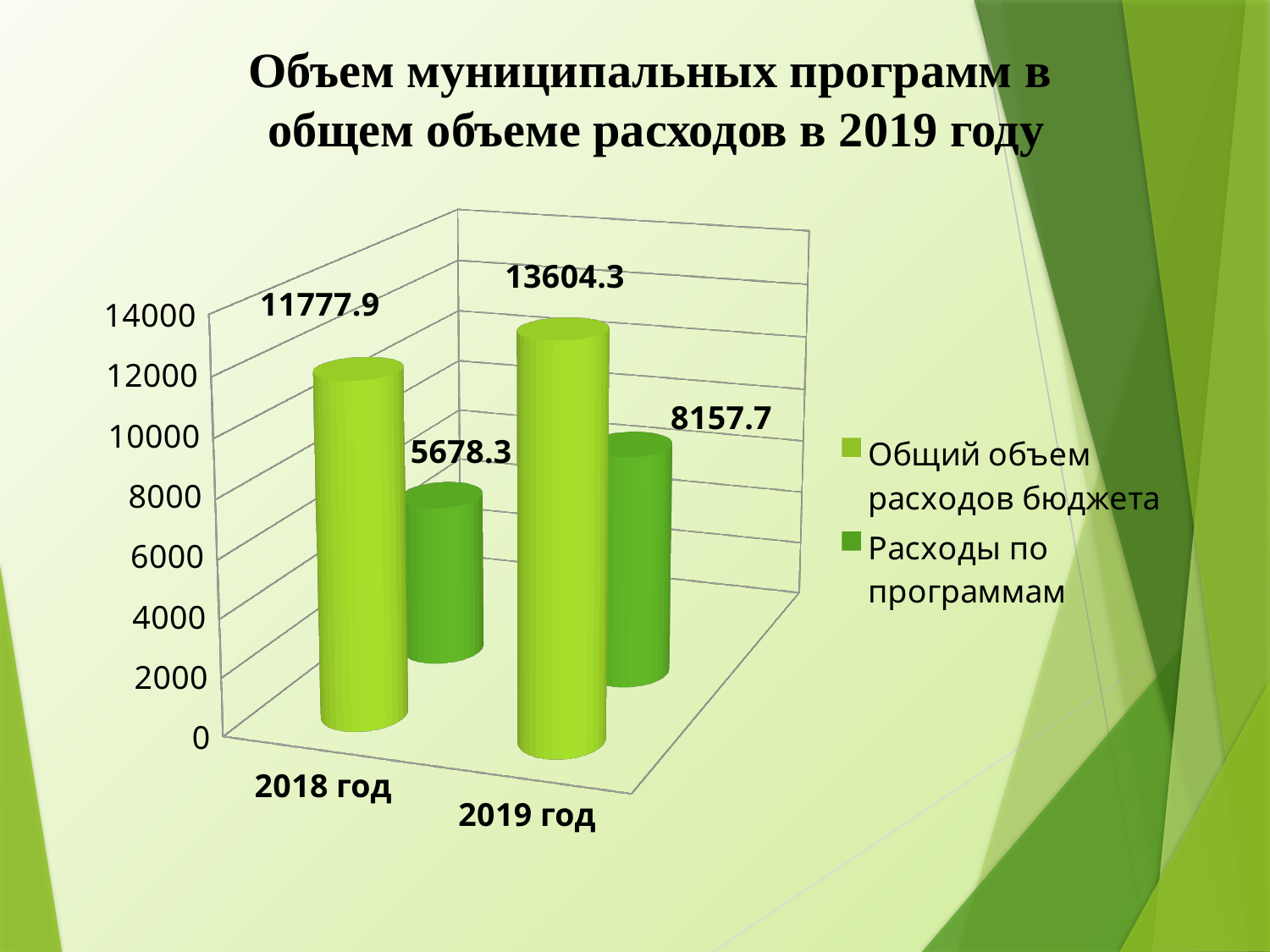
How many series does the legend list? 2 What is the value of "Общий объем расходов бюджета" for 2018 год? 11777.9 Which year has the lower value for "Расходы по программам"? 2018 год What is the value of "Расходы по программам" for 2018 год? 5678.3 What is the difference between "Общий объем расходов бюджета" and "Расходы по программам" in 2019 год? 5446.6 Is the value of "Расходы по программам" for 2018 год greater or less than 6000? less By how much did "Расходы по программам" increase from 2018 год to 2019 год? 2479.4 What is the value of "Расходы по программам" for 2019 год? 8157.7 What is the value of "Общий объем расходов бюджета" for 2019 год? 13604.3 What kind of chart is shown on the slide? Bar chart Which year has the higher value for "Общий объем расходов бюджета"? 2019 год Does "Общий объем расходов бюджета" rise or fall from 2018 год to 2019 год? Rise